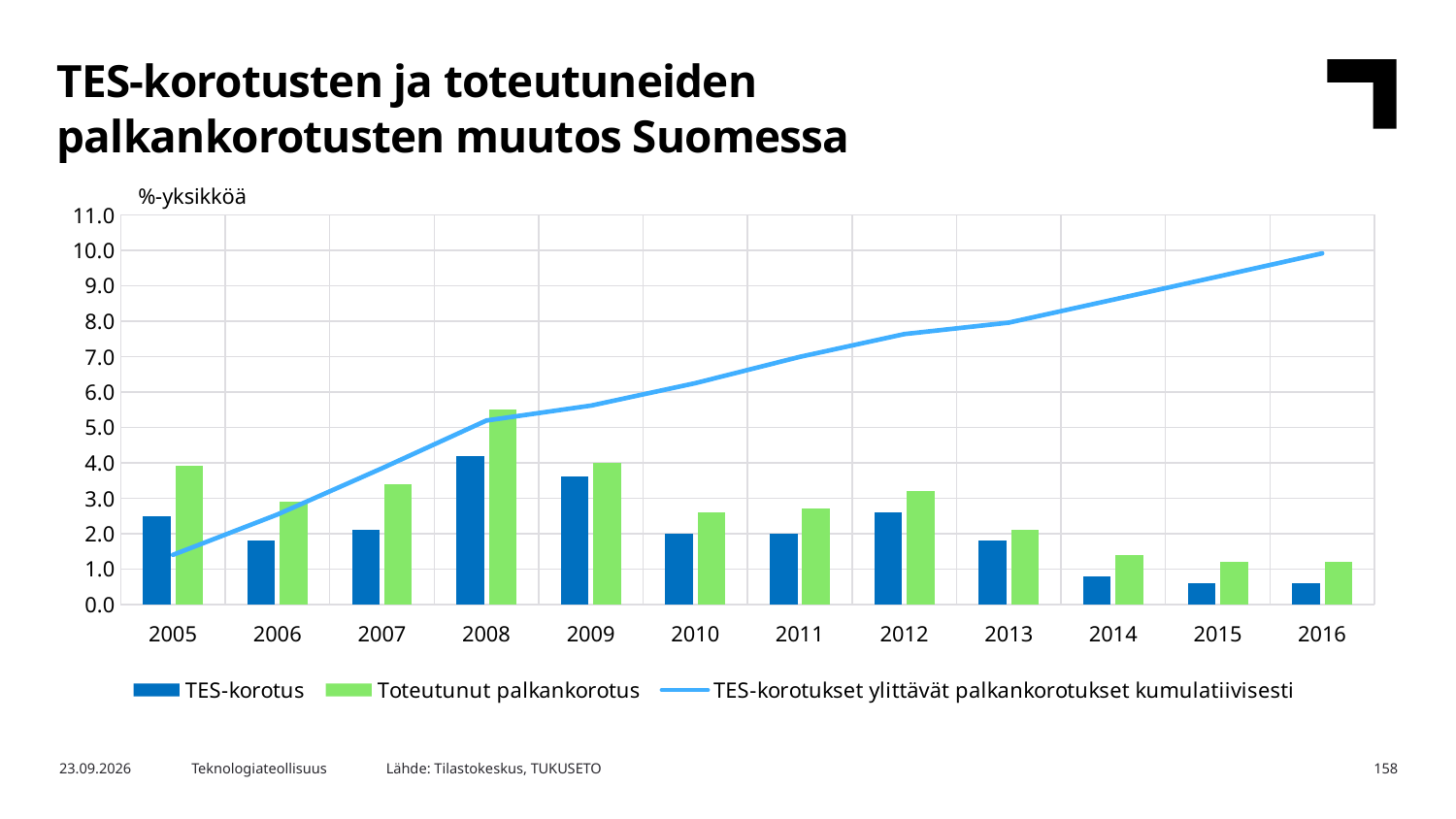
Does the line for TES-korotukset ylittävät palkankorotukset kumulatiivisesti rise or fall from 2005 to 2016? Rises What kind of chart is shown on the slide? A bar chart combined with a line How many years are shown on the x axis? 12 Is the Toteutunut palkankorotus value for 2008 greater or less than 5.0? greater In 2005, which is larger: TES-korotus or Toteutunut palkankorotus? Toteutunut palkankorotus Is the Toteutunut palkankorotus value for 2005 greater or less than 3.0? greater Is the value of the cumulative line in 2016 greater or less than 9.0? greater What unit is shown above the y axis? %-yksikköä In which year is the Toteutunut palkankorotus bar highest? 2008 How many series does the legend list? 3 In which year is the TES-korotus bar highest? 2008